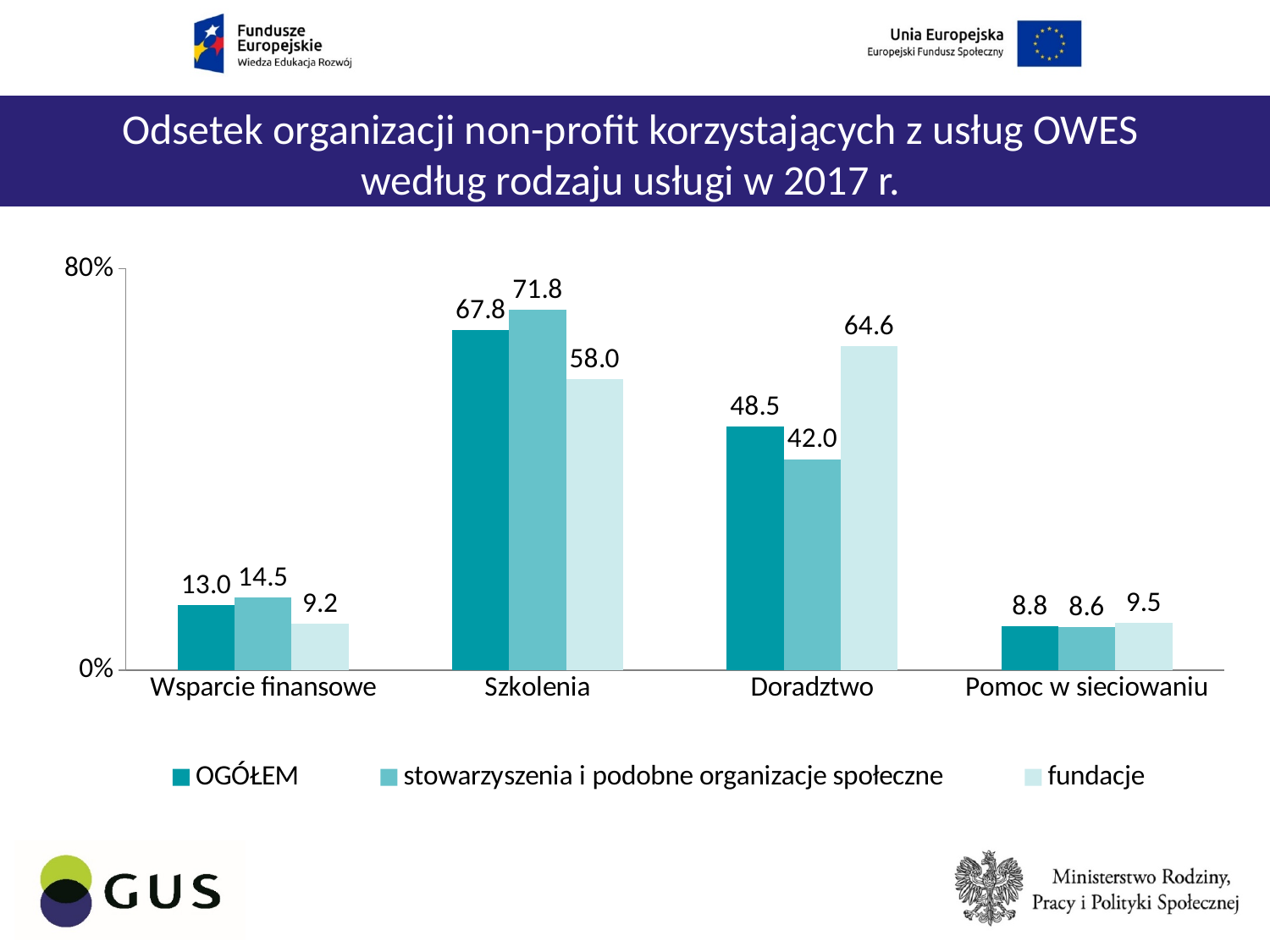
Which category has the highest value for OGÓŁEM? Szkolenia Which category has the lowest value for fundacje? Wsparcie finansowe In the Doradztwo category, which is larger: the OGÓŁEM value or the stowarzyszenia i podobne organizacje społeczne value? OGÓŁEM How many categories are shown on the x axis? 4 How many series does the legend list? 3 What is the difference between the OGÓŁEM value for Szkolenia and the OGÓŁEM value for Doradztwo? 19.3 What kind of chart is shown on the slide? bar chart What is the title of the chart? Odsetek organizacji non-profit korzystających z usług OWES według rodzaju usługi w 2017 r. What is the value for OGÓŁEM in the Szkolenia category? 67.8 What is the difference between the stowarzyszenia i podobne organizacje społeczne value and the fundacje value in the Szkolenia category? 13.8 What is the value for stowarzyszenia i podobne organizacje społeczne in the Wsparcie finansowe category? 14.5 What is the value for fundacje in the Doradztwo category? 64.6